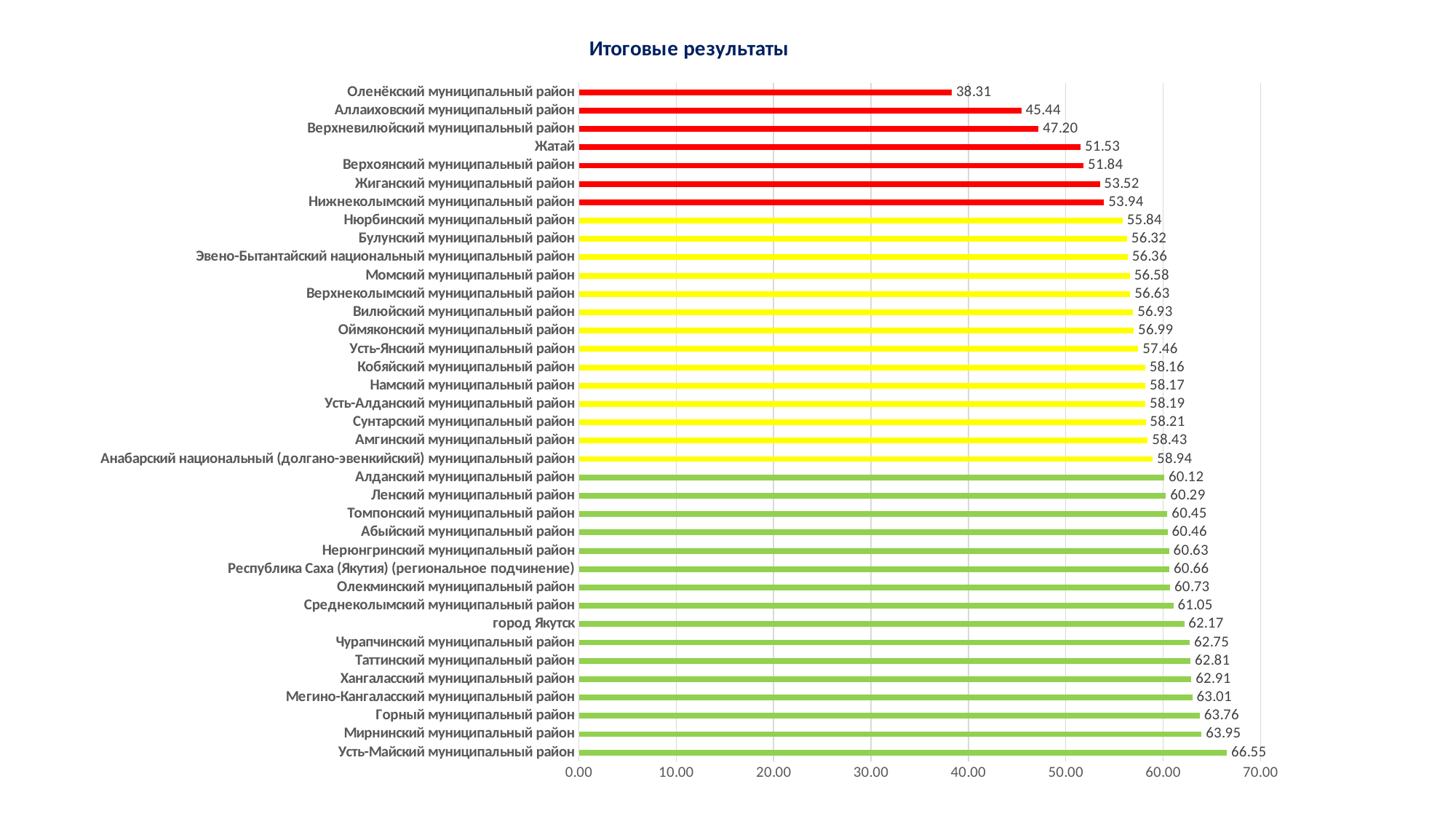
Which category has the lowest value? Оленёкский муниципальный район What is the value for Жатай? 51.53 How many categories are shown in the chart? 37 What is the difference between the values for Усть-Майский муниципальный район and Оленёкский муниципальный район? 28.24 What is the title of the chart? Итоговые результаты What is the value for город Якутск? 62.17 How many bars are coloured red? 7 What is the value for Момский муниципальный район? 56.58 What kind of chart is this? bar chart Is the value for Аллаиховский муниципальный район greater or less than 50.00? less Which is larger: the value for Мирнинский муниципальный район or the value for Горный муниципальный район? Мирнинский муниципальный район Which category has the highest value? Усть-Майский муниципальный район